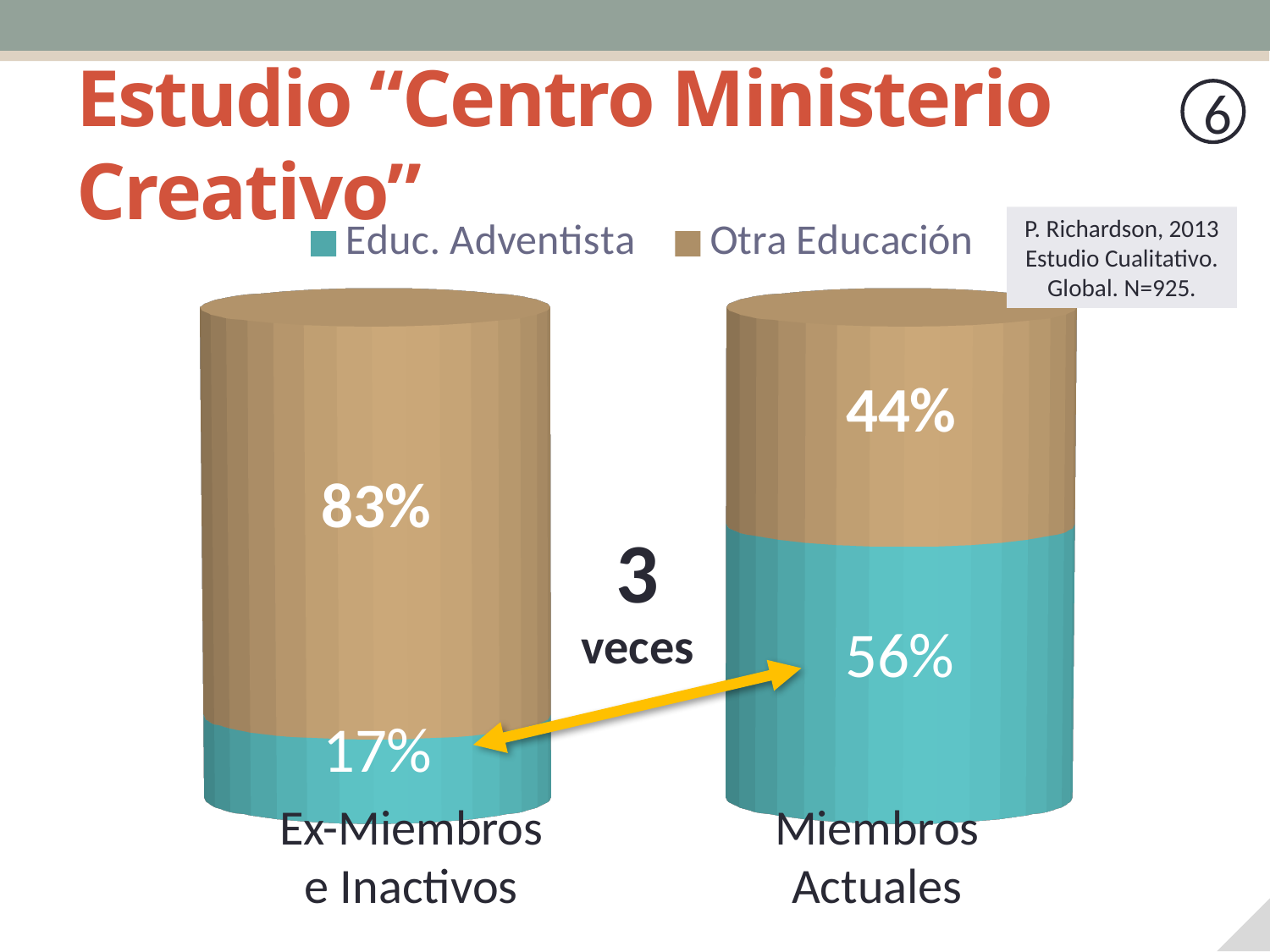
What is the value for Otra Educación in the Miembros Actuales bar? 44% Which category has the lowest Otra Educación value? Miembros Actuales How many series does the legend list? 2 Which category has the higher Educ. Adventista value? Miembros Actuales What is the difference between the Otra Educación values for Ex-Miembros e Inactivos and Miembros Actuales? 39% What is the total of the Miembros Actuales stacked bar? 100% What is the value for Educ. Adventista in the Ex-Miembros e Inactivos bar? 17% What is the value for Otra Educación in the Ex-Miembros e Inactivos bar? 83% What is the difference between the Educ. Adventista values for Miembros Actuales and Ex-Miembros e Inactivos? 39% How many categories are shown on the x axis? 2 What kind of chart is shown on the slide? Stacked bar chart What is the value for Educ. Adventista in the Miembros Actuales bar? 56%